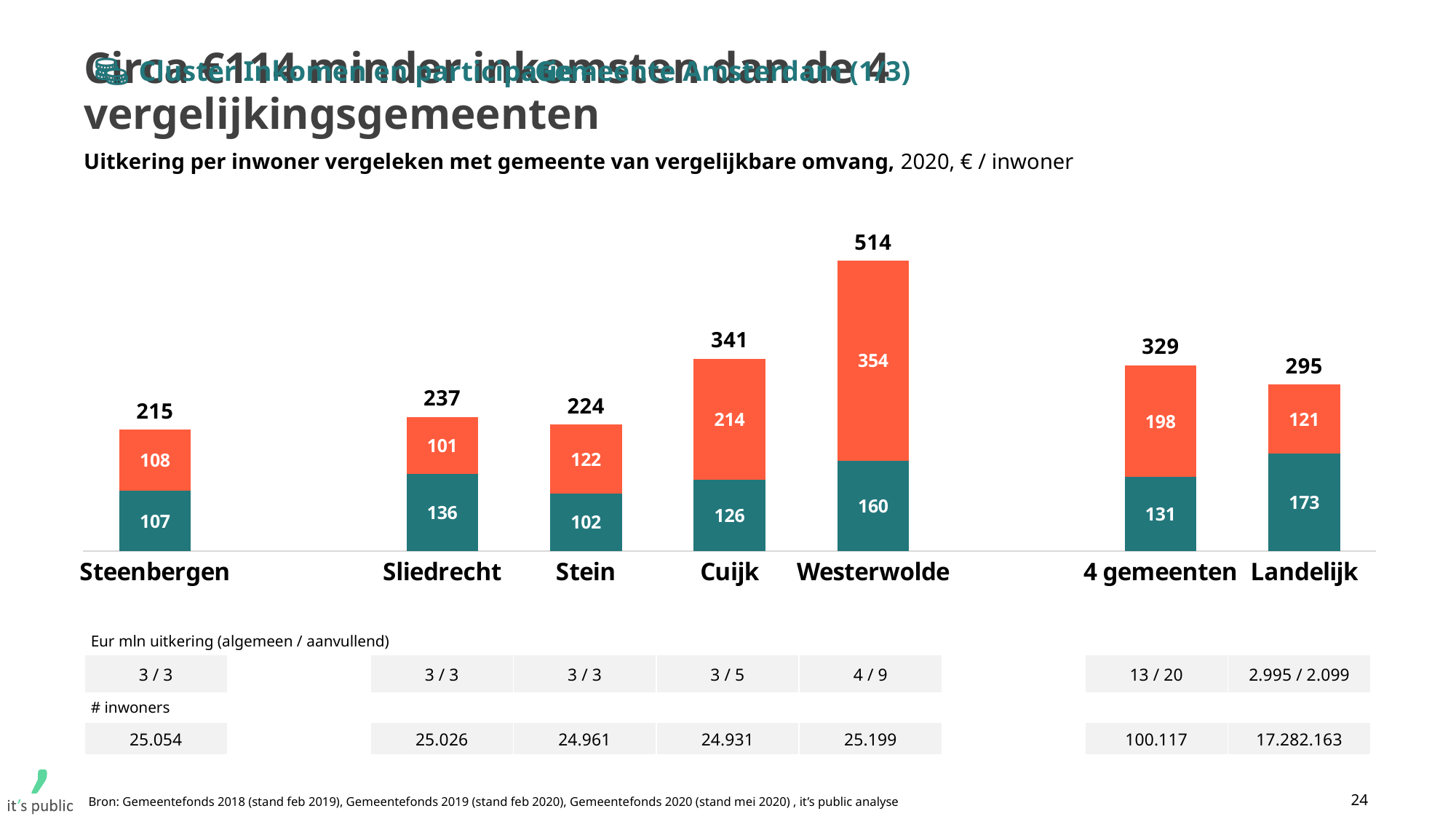
Which category has the lowest total value? Steenbergen What kind of chart is shown on the slide? Stacked bar chart How many categories are shown on the x axis of the chart? 7 What is the difference between the total for Westerwolde and the total for Cuijk? 173 What is the value of the teal (bottom) segment for Sliedrecht? 136 Which has a larger total value, 4 gemeenten or Landelijk? 4 gemeenten What is the difference between the teal (bottom) segments of Landelijk and Steenbergen? 66 What is the total value shown above the bar for Landelijk? 295 What is the value of the orange (top) segment for Cuijk? 214 What is the total value shown above the bar for Westerwolde? 514 Which category has the highest total value? Westerwolde Which has a larger orange (top) segment, Stein or Sliedrecht? Stein